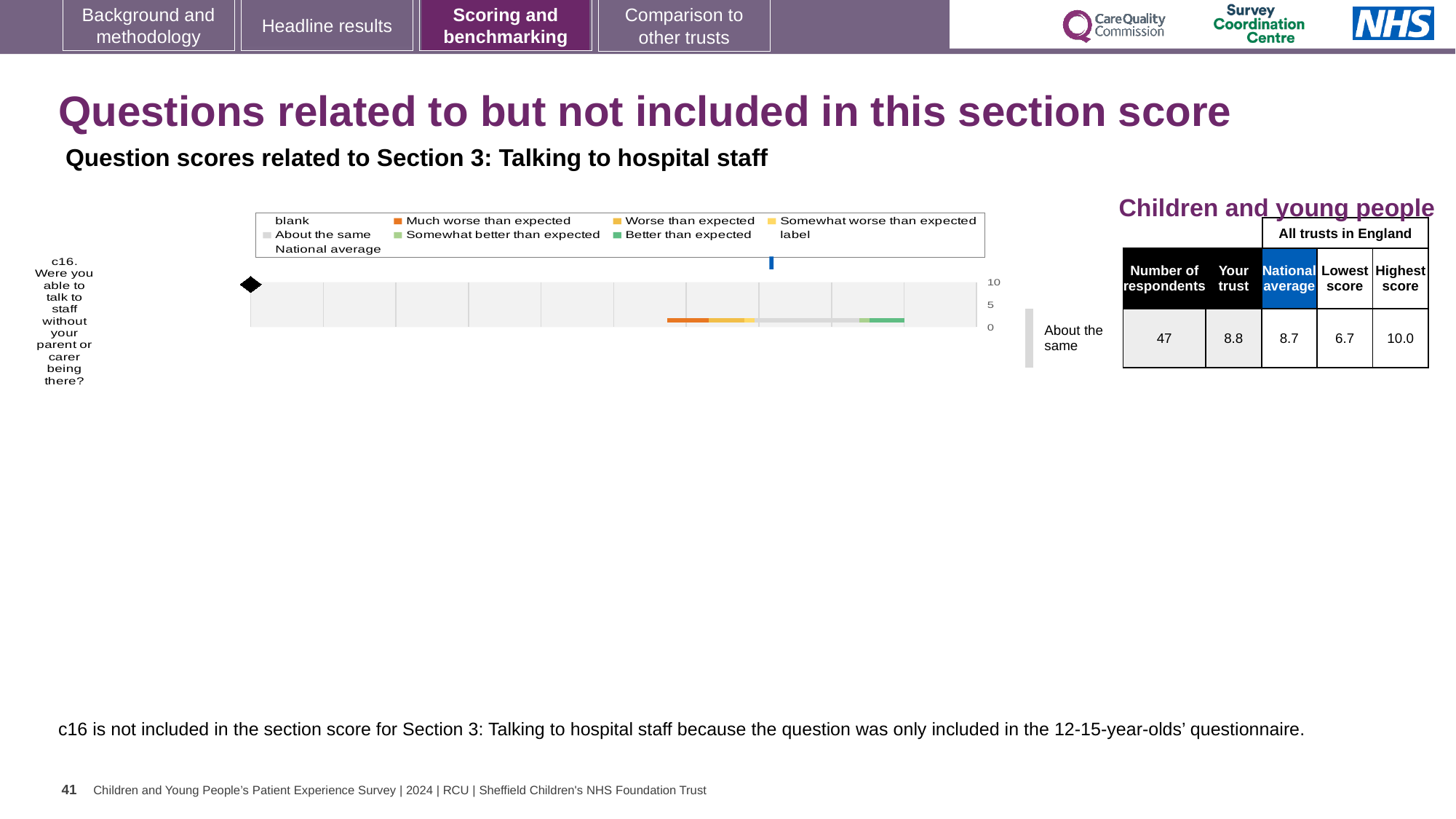
In the table next to the chart, what is the 'Your trust' score for c16? 8.8 What kind of chart is shown on the slide? bar chart Which is larger for c16, the 'Your trust' score or the National average? Your trust Which survey question is plotted in the chart? c16. Were you able to talk to staff without your parent or carer being there? What is the highest tick value shown on the chart's axis? 10 How many respondents answered question c16? 47 In the table next to the chart, what is the Lowest score across all trusts in England for c16? 6.7 How many survey questions are plotted in the chart? 1 Which benchmark category is the trust's c16 result placed in? About the same What is the difference between the Highest score and the Lowest score for c16? 3.3 In the table next to the chart, what is the Highest score across all trusts in England for c16? 10.0 In the table next to the chart, what is the National average score for c16? 8.7